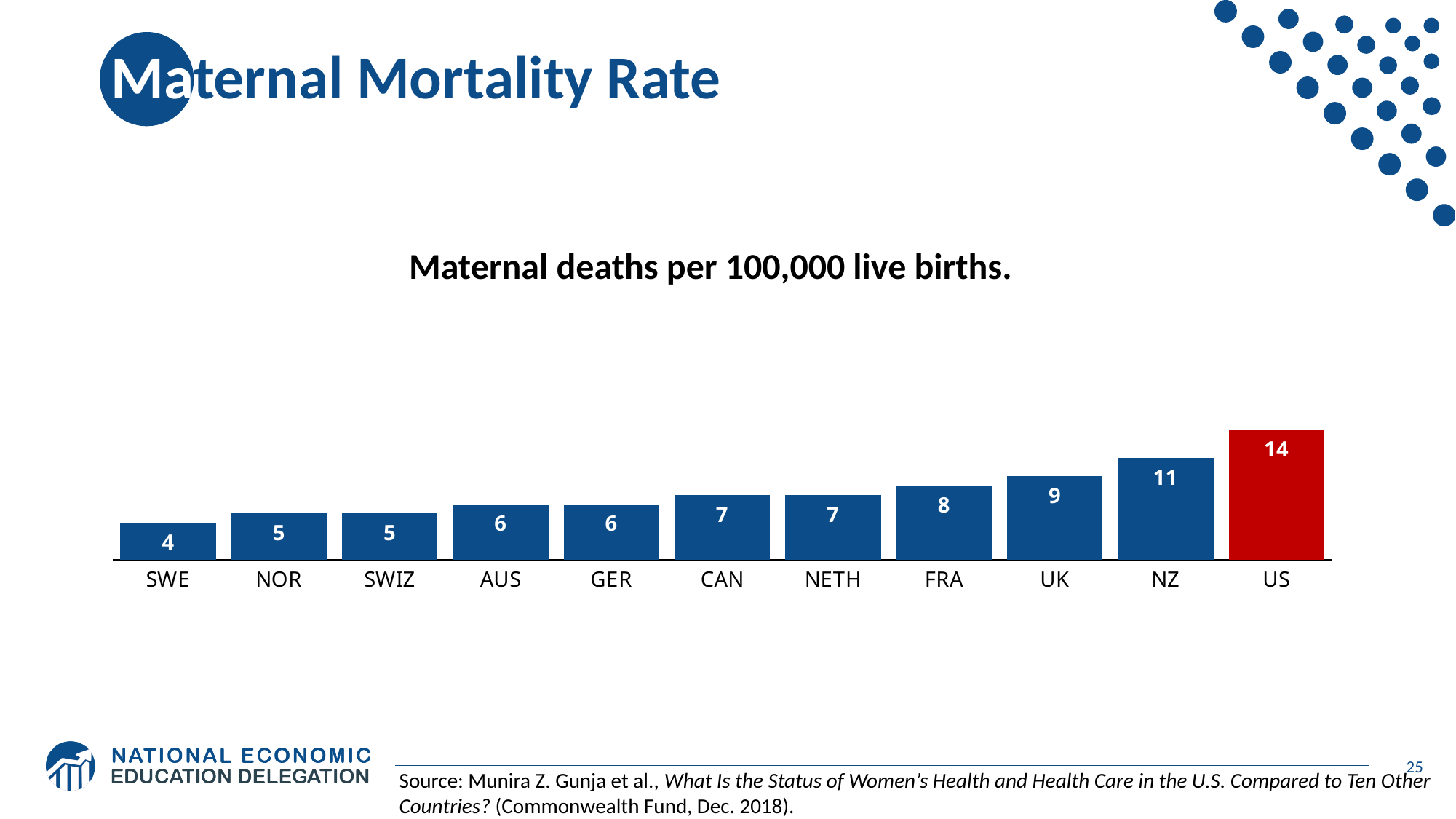
What is the maternal mortality rate shown for the US? 14 Which country has the highest maternal mortality rate on the chart? US Which country has the lowest maternal mortality rate on the chart? SWE Which bar is coloured red rather than blue? US How many countries are shown on the chart? 11 What is the difference between the values for NZ and SWE? 7 What is the difference between the values for the US and the UK? 5 Do the values rise or fall moving from left to right along the x axis? Rise Which has a higher value, FRA or AUS? FRA What kind of chart is shown on the slide? Bar chart What value is shown for NZ? 11 What value is shown for SWE? 4